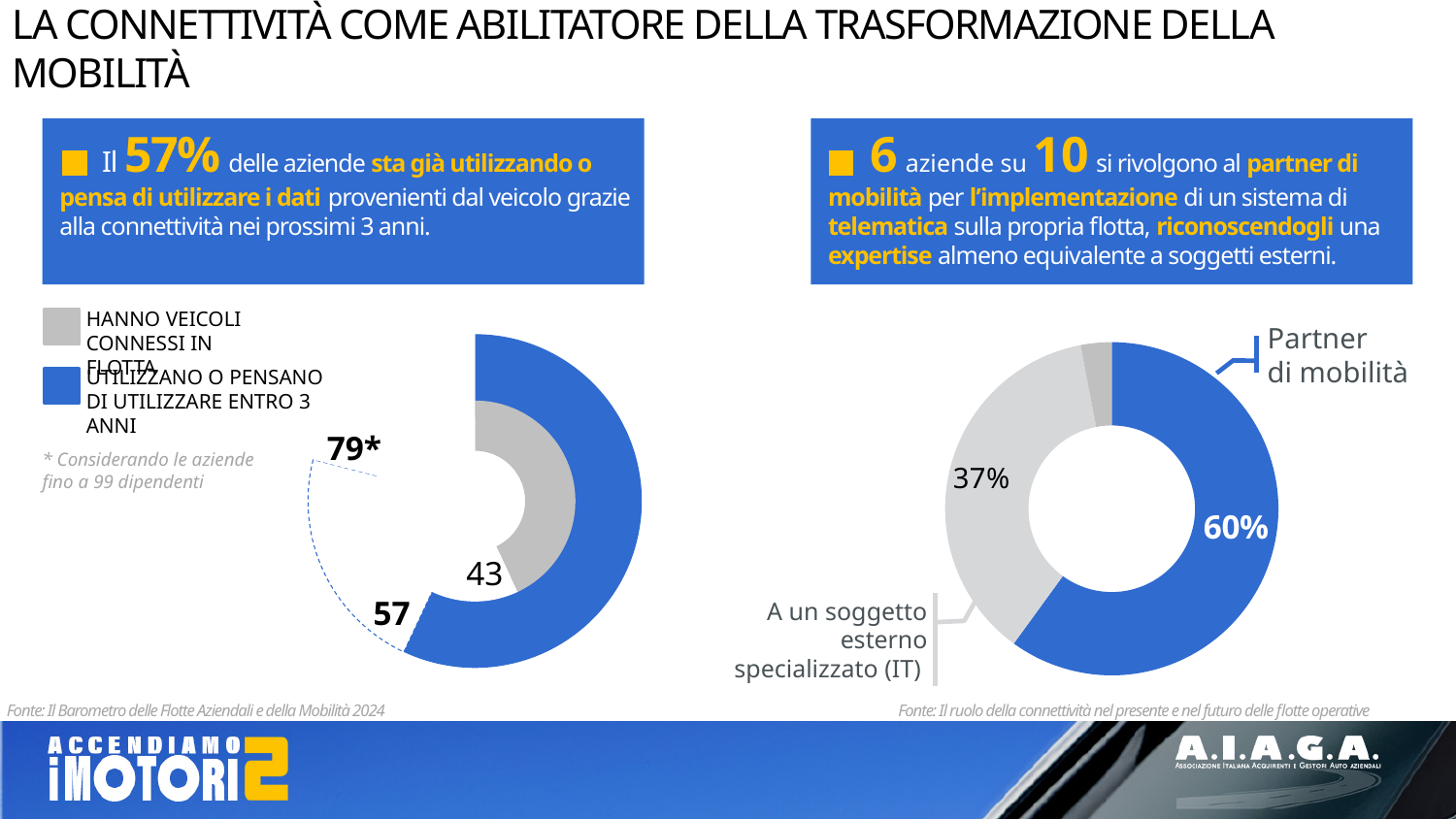
How many entries does the legend of the left chart list? 2 On the right chart, what is the difference in percentage points between 'Partner di mobilità' and 'A un soggetto esterno specializzato (IT)'? 23 percentage points On the right chart, what share is shown for 'Partner di mobilità'? 60% On the left chart, what value is shown for the grey ring 'Hanno veicoli connessi in flotta'? 43 On the left chart, what is the difference between the value 57 and the value 43? 14 On the right chart, which slice is the largest? Partner di mobilità On the left chart, what value is shown with an asterisk for companies with up to 99 employees? 79* On the left chart, which is larger: the value for 'Utilizzano o pensano di utilizzare entro 3 anni' or for 'Hanno veicoli connessi in flotta'? Utilizzano o pensano di utilizzare entro 3 anni On the right chart, what colour is the 'Partner di mobilità' slice? Blue On the left chart, what value is shown for the blue ring 'Utilizzano o pensano di utilizzare entro 3 anni'? 57 On the right chart, what share is shown for 'A un soggetto esterno specializzato (IT)'? 37% What kind of chart is the left chart? Donut (pie) chart